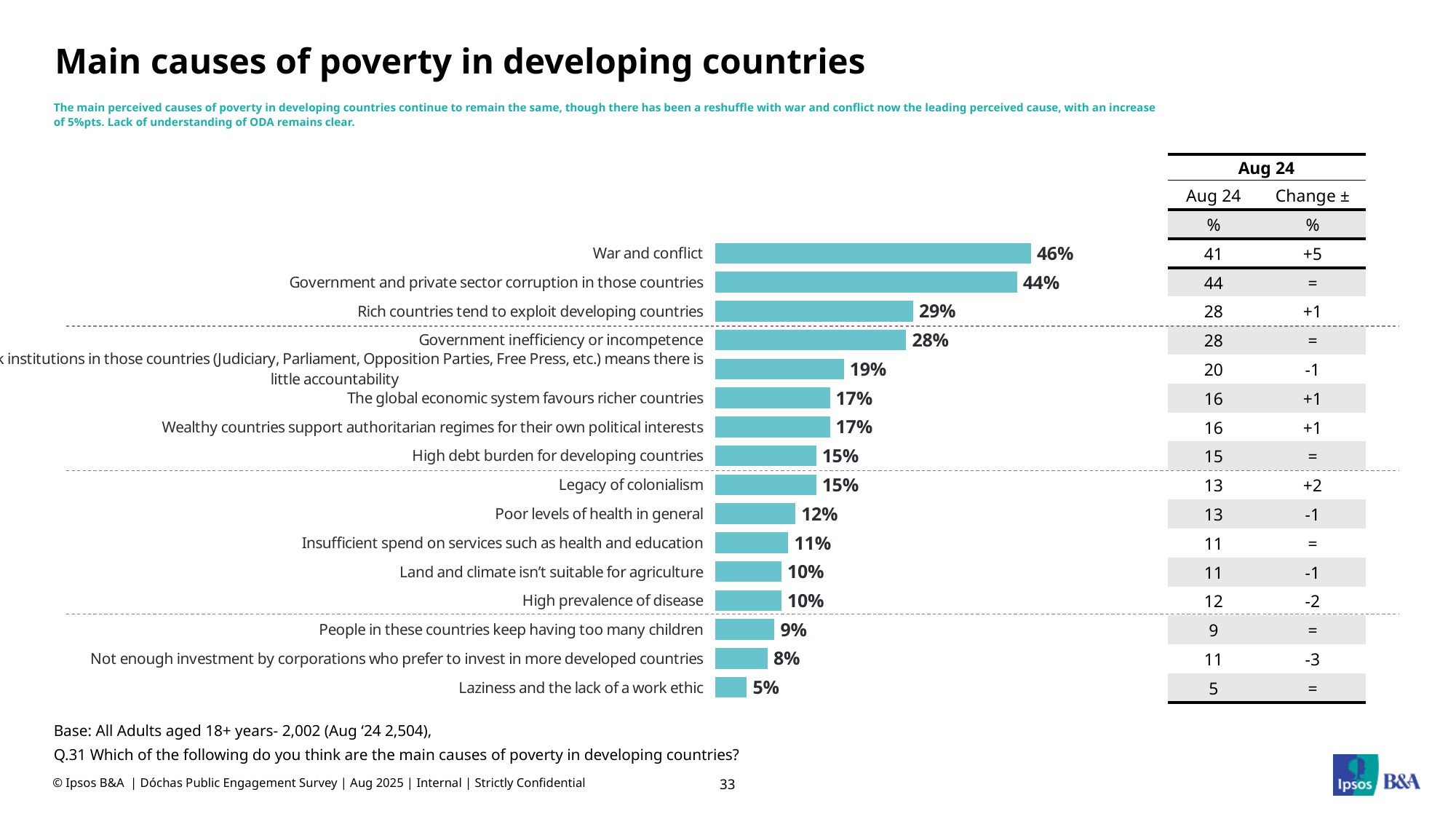
Which cause of poverty has the lowest percentage in the chart? Laziness and the lack of a work ethic What is the difference between 'Rich countries tend to exploit developing countries' and 'High debt burden for developing countries'? 14% Which cause of poverty has the highest percentage in the chart? War and conflict What is the value shown for 'Laziness and the lack of a work ethic'? 5% According to the table, what was the Aug 24 percentage for 'War and conflict'? 41 According to the table, what is the change for 'Not enough investment by corporations who prefer to invest in more developed countries'? -3 What type of chart is used on this slide? Bar chart Which is larger: the value for 'Poor levels of health in general' or the value for 'High prevalence of disease'? Poor levels of health in general What is the value shown for 'Legacy of colonialism'? 15% How many causes of poverty are listed in the bar chart? 16 What percentage of respondents cited war and conflict as a main cause of poverty in developing countries? 46% What is the difference between the percentages for 'War and conflict' and 'Government and private sector corruption in those countries'? 2%